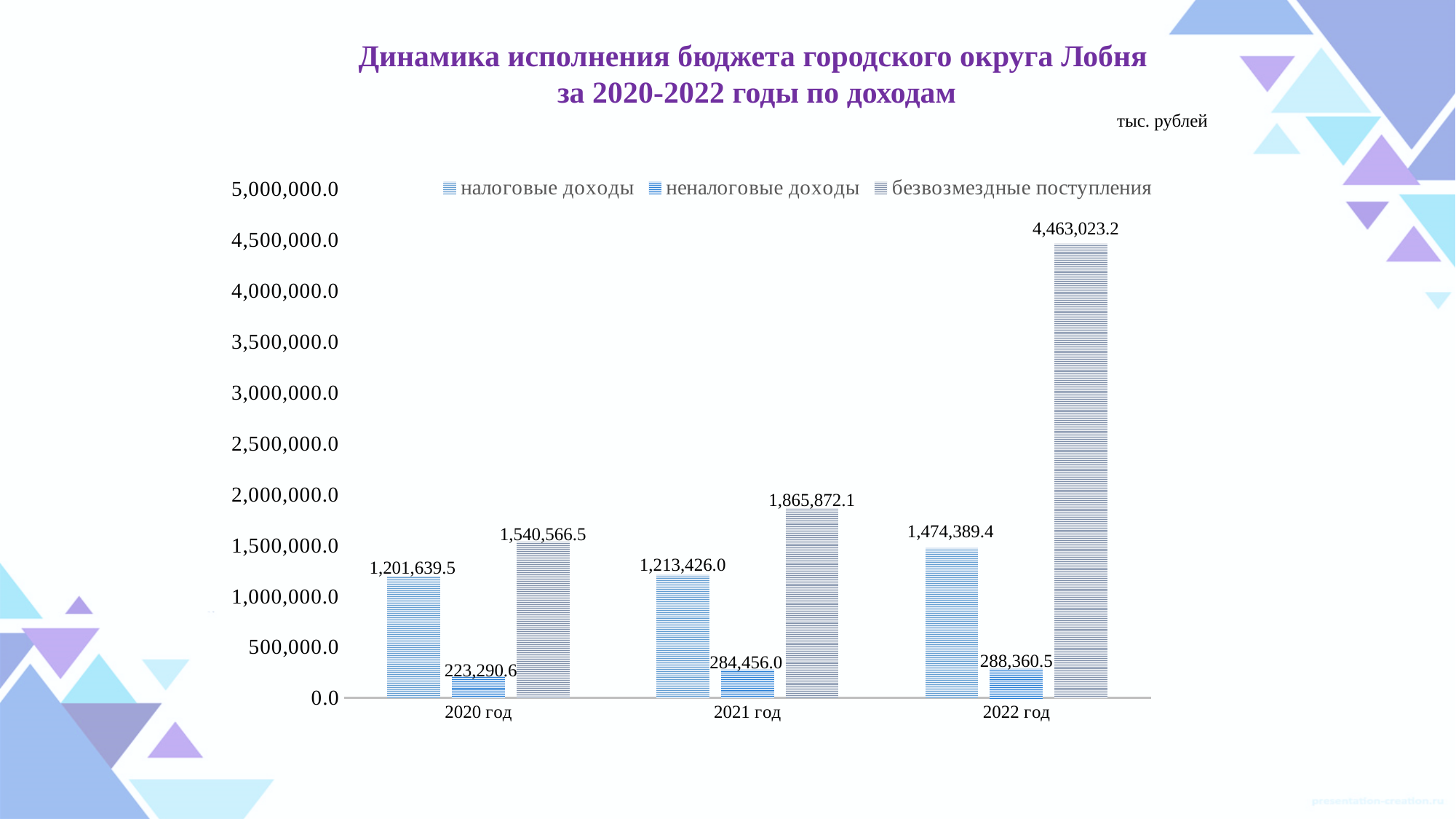
In which year is безвозмездные поступления the highest? 2022 год What is the value of неналоговые доходы for 2021 год? 284,456.0 What is the difference between налоговые доходы in 2022 год and in 2020 год? 272,749.9 What is the value of налоговые доходы for 2020 год? 1,201,639.5 Is the value of безвозмездные поступления for 2022 год greater or less than 4,000,000.0? greater How many series does the legend list? 3 What is the difference between безвозмездные поступления in 2022 год and in 2021 год? 2,597,151.1 What is the value of безвозмездные поступления for 2022 год? 4,463,023.2 Do the values of налоговые доходы rise or fall from 2020 год to 2022 год? rise How many years are shown on the x axis? 3 Which is larger in 2021 год: налоговые доходы or безвозмездные поступления? безвозмездные поступления In which year is неналоговые доходы the lowest? 2020 год